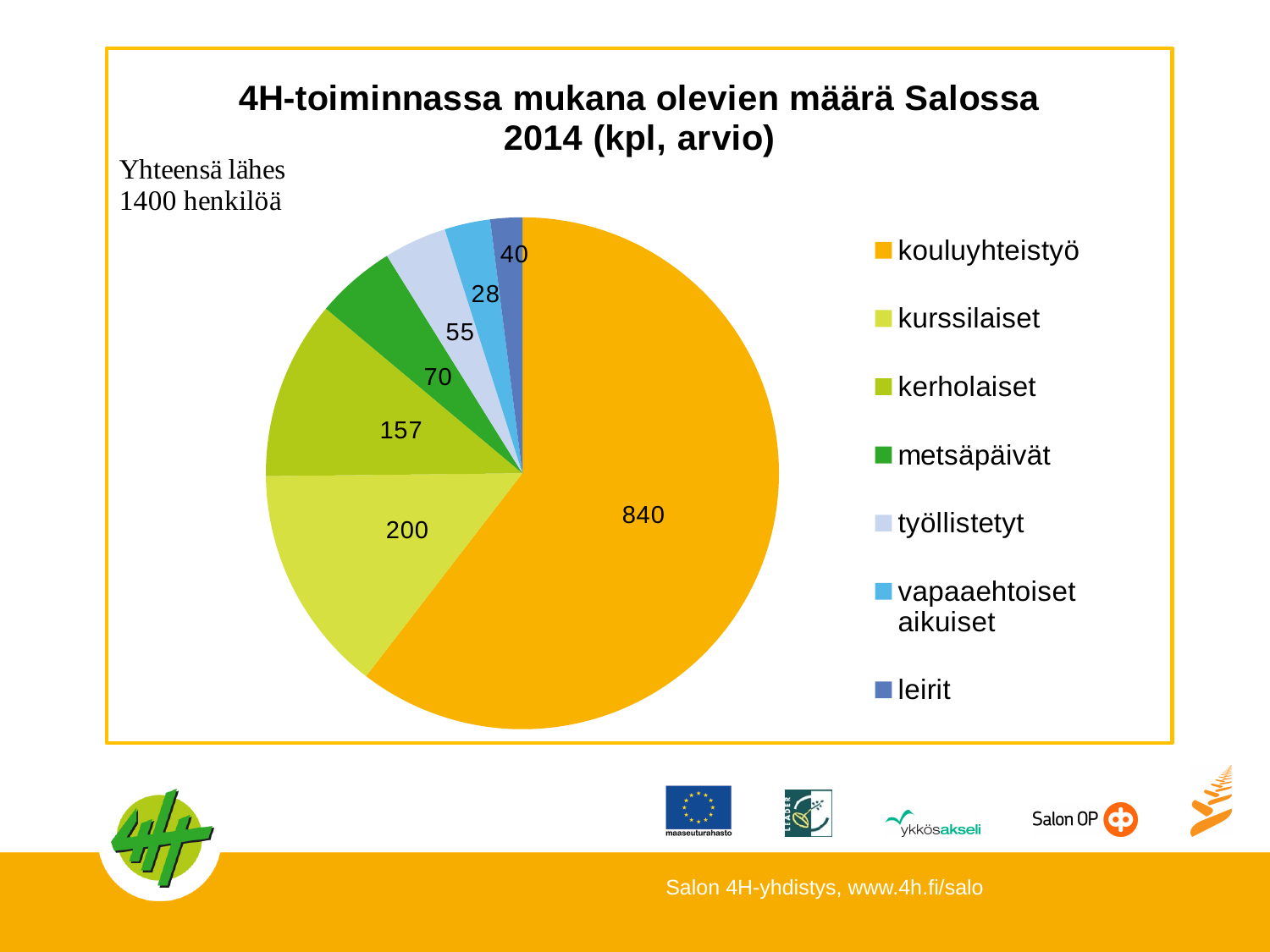
Which category has the largest slice of the pie? kouluyhteistyö What is the value for leirit? 40 What is the value for kerholaiset? 157 Which category has the smallest slice of the pie? vapaaehtoiset aikuiset What is the total of all the values shown in the pie chart? 1390 What type of chart is shown on the slide? pie chart What is the value for kouluyhteistyö? 840 How many categories does the pie chart have? 7 What is the value for kurssilaiset? 200 What is the title of the chart? 4H-toiminnassa mukana olevien määrä Salossa 2014 (kpl, arvio) What is the difference between the values for kouluyhteistyö and kurssilaiset? 640 Which is larger, the value for metsäpäivät or the value for työllistetyt? metsäpäivät